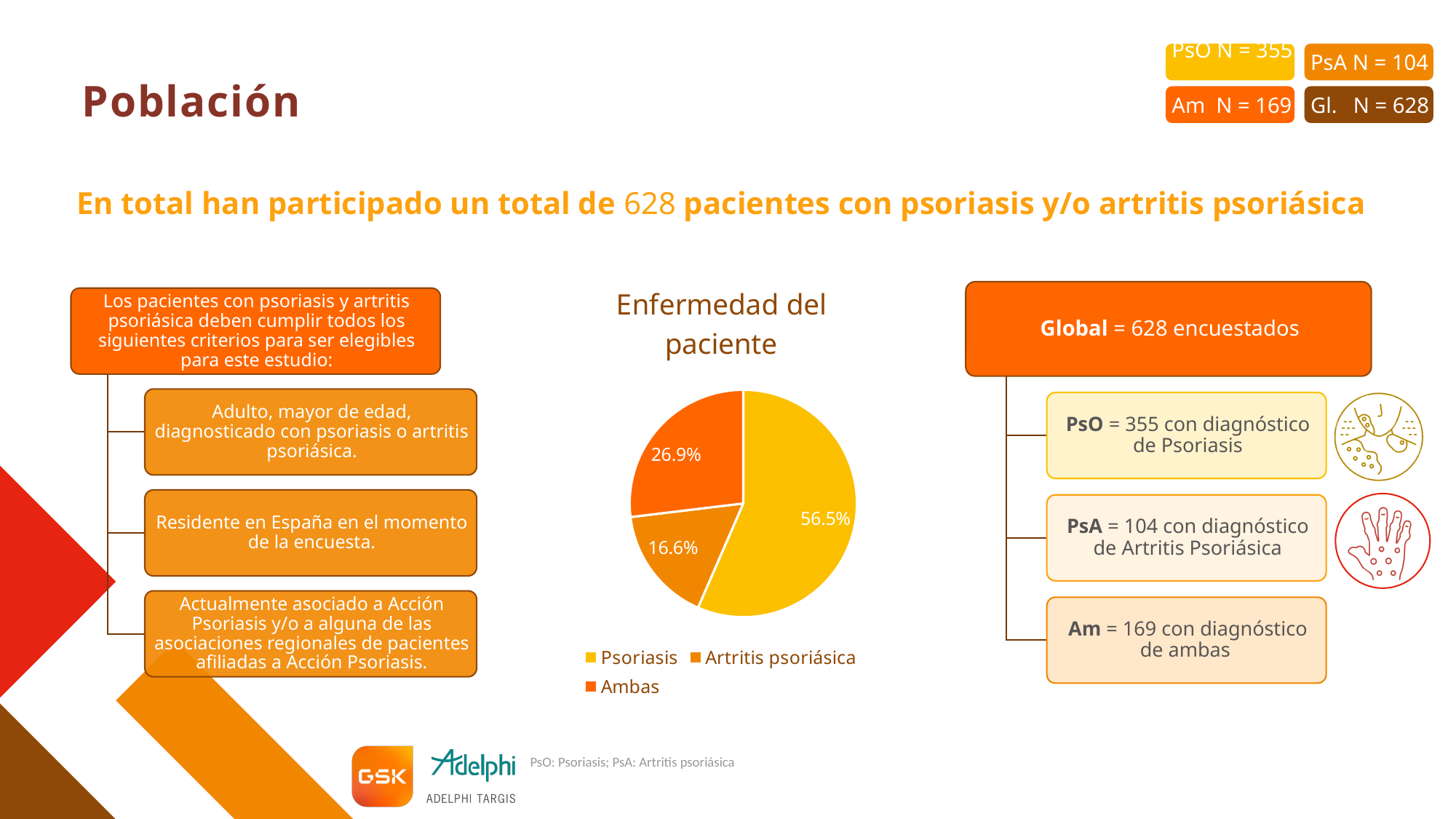
Which slice of the pie chart is the smallest? Artritis psoriásica What percentage of the pie chart is Artritis psoriásica? 16.6% What is the difference in percentage points between the Psoriasis slice and the Ambas slice? 29.6 What percentage of the pie chart is Ambas? 26.9% How many entries does the pie chart legend list? 3 What is the title of the pie chart? Enfermedad del paciente How many slices does the pie chart have? 3 What colour is the Psoriasis slice in the pie chart? yellow Which is larger in the pie chart, Ambas or Artritis psoriásica? Ambas Which slice of the pie chart is the largest? Psoriasis What percentage of the pie chart is Psoriasis? 56.5% What kind of chart is shown under the title "Enfermedad del paciente"? pie chart